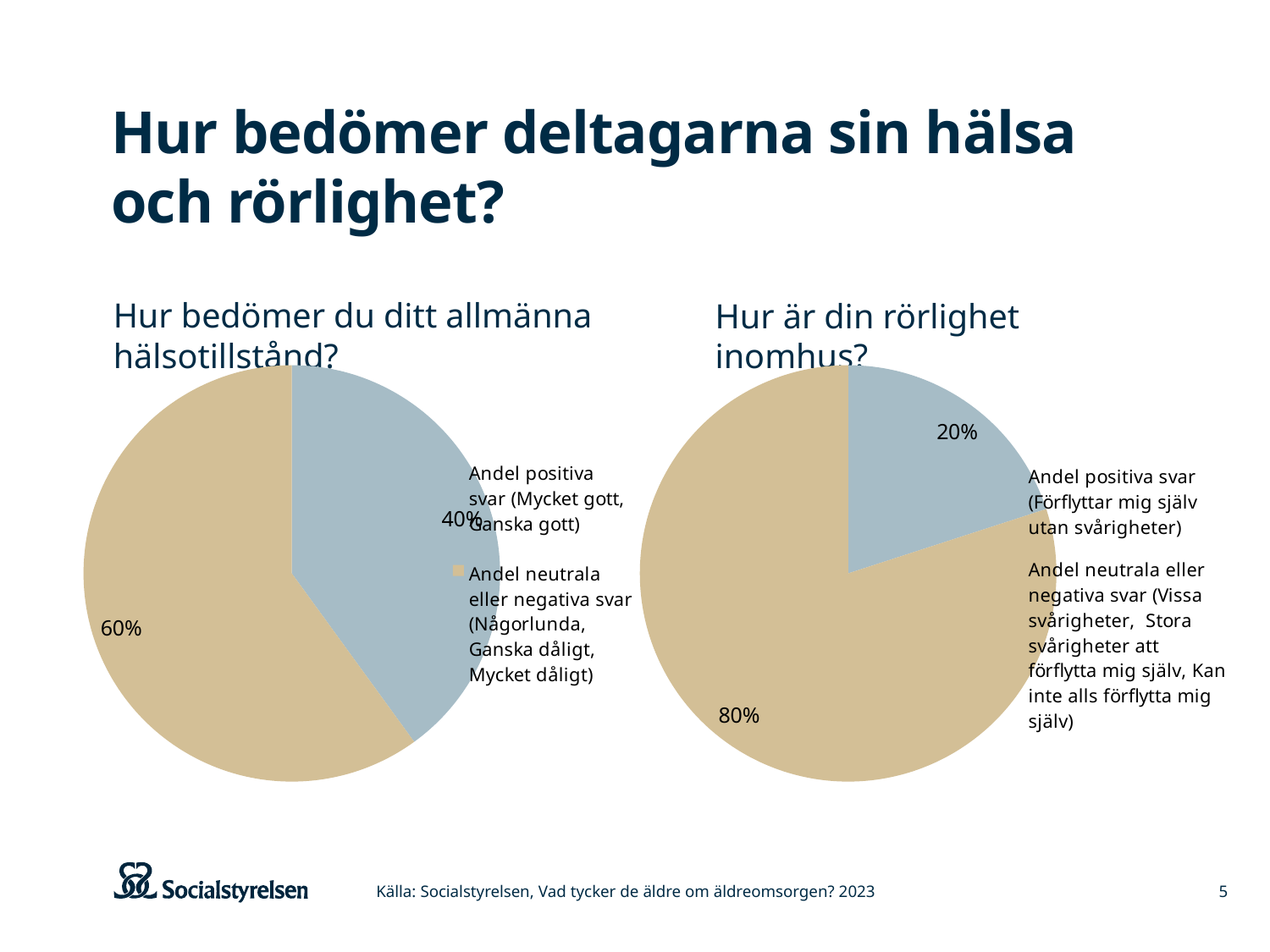
In the right chart 'Hur är din rörlighet inomhus?', what share is 'Andel positiva svar'? 20% In the left chart 'Hur bedömer du ditt allmänna hälsotillstånd?', which slice is the largest? Andel neutrala eller negativa svar In the left chart 'Hur bedömer du ditt allmänna hälsotillstånd?', what is the difference between the neutral/negative share and the positive share? 20 percentage points In the left chart 'Hur bedömer du ditt allmänna hälsotillstånd?', what share is 'Andel positiva svar'? 40% In the right chart 'Hur är din rörlighet inomhus?', which slice is the smallest? Andel positiva svar What type of chart is used on this slide? Pie chart Which chart has the larger share of 'Andel positiva svar', the left chart or the right chart? The left chart In the left chart 'Hur bedömer du ditt allmänna hälsotillstånd?', what share is 'Andel neutrala eller negativa svar'? 60% In the right chart 'Hur är din rörlighet inomhus?', what is the difference between the neutral/negative share and the positive share? 60 percentage points In the right chart 'Hur är din rörlighet inomhus?', what share is 'Andel neutrala eller negativa svar'? 80% How many slices does the right chart 'Hur är din rörlighet inomhus?' have? 2 What is the title of the left chart? Hur bedömer du ditt allmänna hälsotillstånd?